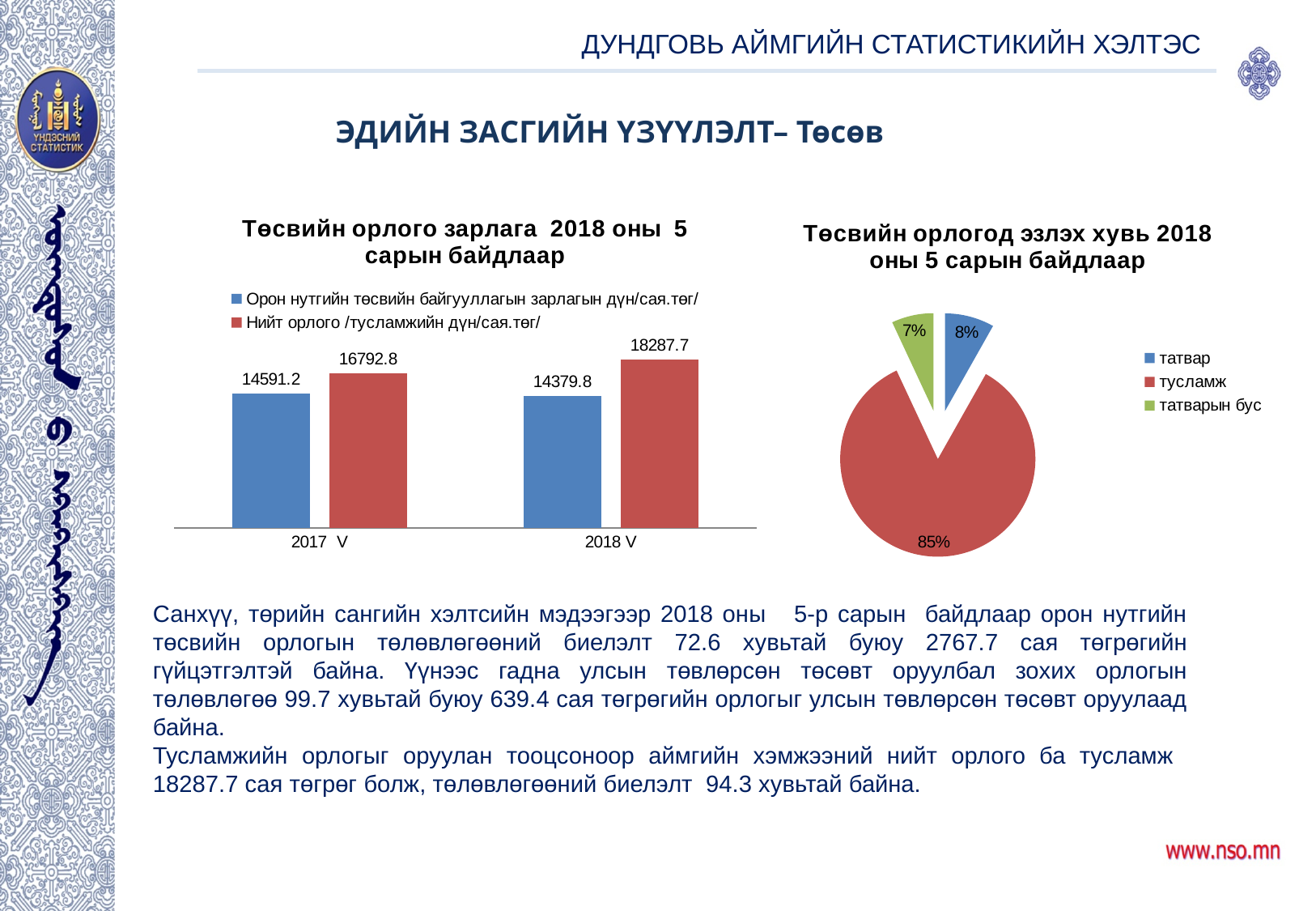
In the pie chart 'Төсвийн орлогод эзлэх хувь 2018 оны 5 сарын байдлаар', what colour is the 'тусламж' slice? Red In the bar chart 'Төсвийн орлого зарлага 2018 оны 5 сарын байдлаар', which year has the higher value for 'Орон нутгийн төсвийн байгууллагын зарлагын дүн/сая.төг/', 2017 V or 2018 V? 2017 V In the bar chart 'Төсвийн орлого зарлага 2018 оны 5 сарын байдлаар', what is the difference between 'Нийт орлого /тусламжийн дүн/сая.төг/' and 'Орон нутгийн төсвийн байгууллагын зарлагын дүн/сая.төг/' for 2018 V? 3907.9 In the pie chart 'Төсвийн орлогод эзлэх хувь 2018 оны 5 сарын байдлаар', which category has the smallest share? татварын бус In the pie chart 'Төсвийн орлогод эзлэх хувь 2018 оны 5 сарын байдлаар', what is the share of 'татвар'? 8% In the bar chart 'Төсвийн орлого зарлага 2018 оны 5 сарын байдлаар', what is the value of 'Орон нутгийн төсвийн байгууллагын зарлагын дүн/сая.төг/' for 2017 V? 14591.2 In the pie chart 'Төсвийн орлогод эзлэх хувь 2018 оны 5 сарын байдлаар', what share does 'тусламж' have? 85% In the bar chart 'Төсвийн орлого зарлага 2018 оны 5 сарын байдлаар', how many categories are shown on the x axis? 2 In the bar chart 'Төсвийн орлого зарлага 2018 оны 5 сарын байдлаар', what is the value of 'Нийт орлого /тусламжийн дүн/сая.төг/' for 2018 V? 18287.7 What kind of chart is the left chart 'Төсвийн орлого зарлага 2018 оны 5 сарын байдлаар'? Bar chart In the bar chart 'Төсвийн орлого зарлага 2018 оны 5 сарын байдлаар', what is the value of 'Нийт орлого /тусламжийн дүн/сая.төг/' for 2017 V? 16792.8 In the bar chart 'Төсвийн орлого зарлага 2018 оны 5 сарын байдлаар', how many series does the legend list? 2